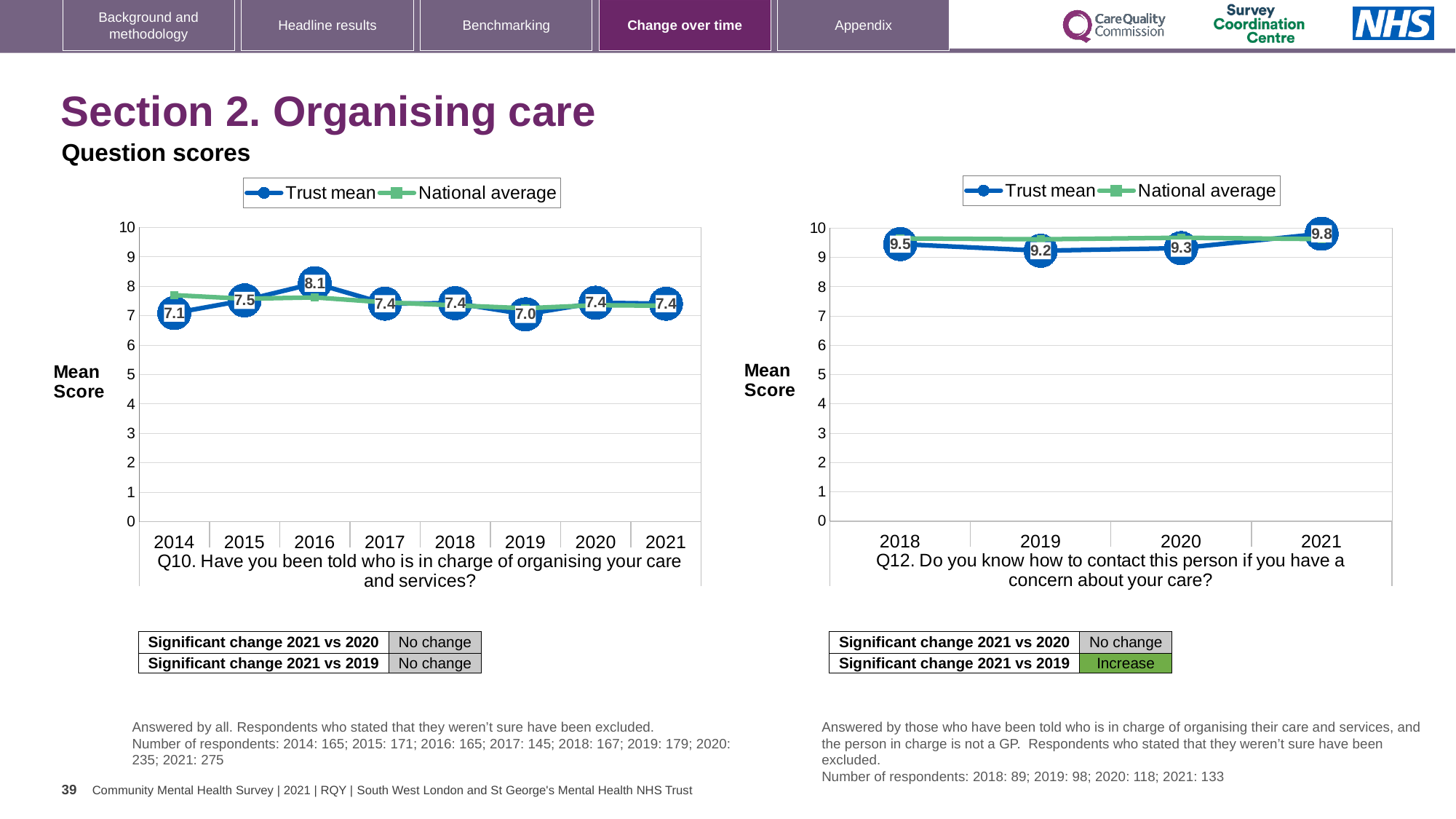
In the Q10 chart on the left, which year has the highest Trust mean? 2016 In the Q10 chart on the left, which year has the lowest Trust mean? 2019 In the Q10 chart on the left, how many years are plotted on the x axis? 8 In the Q10 chart on the left, what is the Trust mean for 2019? 7.0 In the Q12 chart on the right, is the National average for 2018 greater or less than 9? greater In the Q12 chart on the right, what is the Trust mean for 2021? 9.8 In the Q10 chart on the left, what is the Trust mean for 2016? 8.1 In the Q10 chart on the left, what is the difference between the Trust mean in 2016 and in 2014? 1.0 How many series does the legend of the Q12 chart on the right list? 2 What kind of chart is the Q10 chart on the left? Line chart In the Q12 chart on the right, is the Trust mean higher in 2021 or in 2019? 2021 In the Q12 chart on the right, which year has the lowest Trust mean? 2019